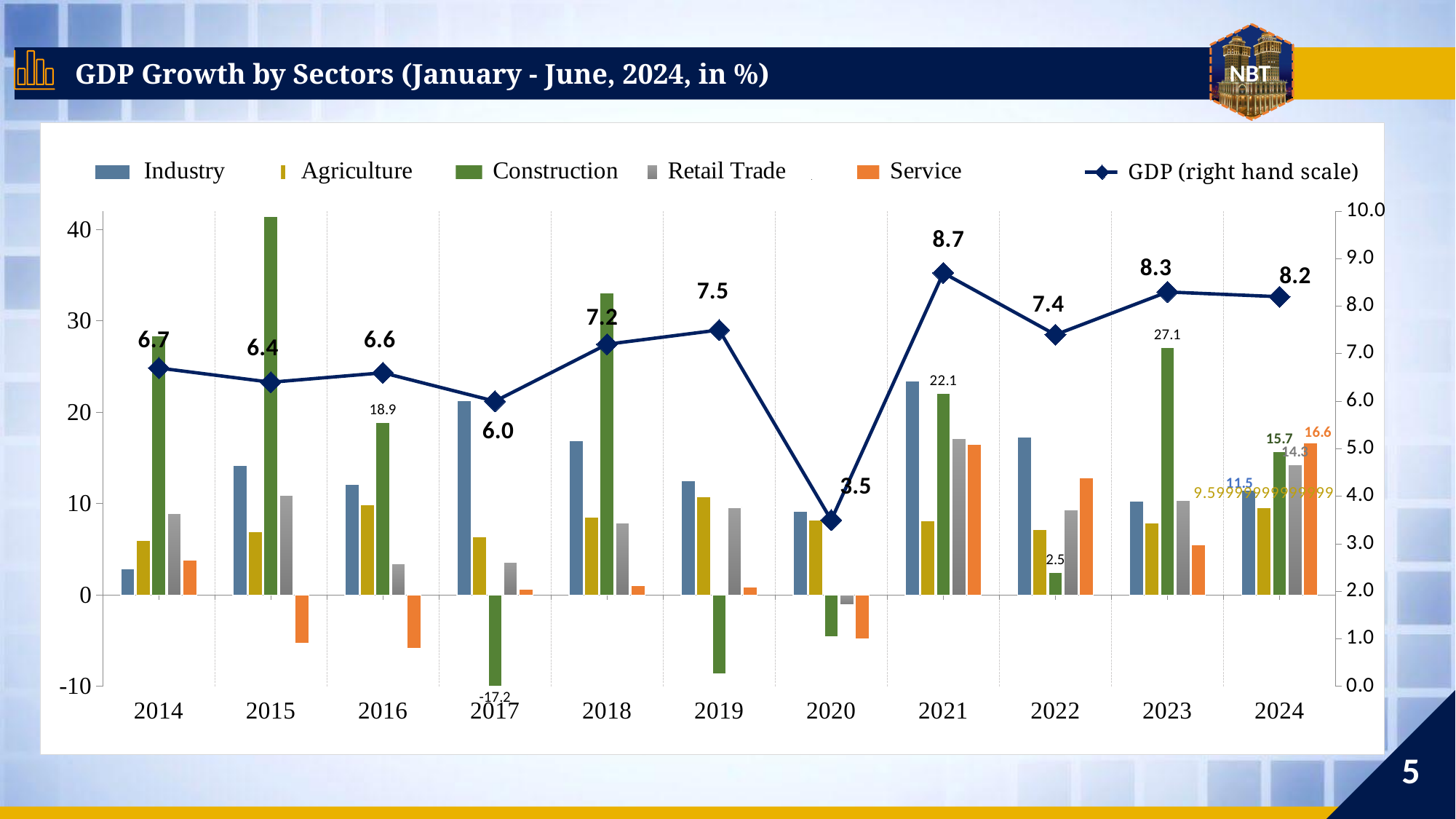
What is the Construction value shown for 2017? -17.2 What is the difference between the GDP values for 2021 and 2020? 5.2 Is the Construction value for 2015 greater or less than 40? greater In which year is the GDP line at its highest? 2021 What kind of chart is this? Combination bar and line chart In which year is the GDP line at its lowest? 2020 What is the Construction value shown for 2023? 27.1 How many series does the legend list? 6 How many years are shown on the x axis? 11 Which year has the higher GDP value, 2023 or 2024? 2023 What is the Service value shown for 2024? 16.6 What is the GDP growth value shown for 2021? 8.7